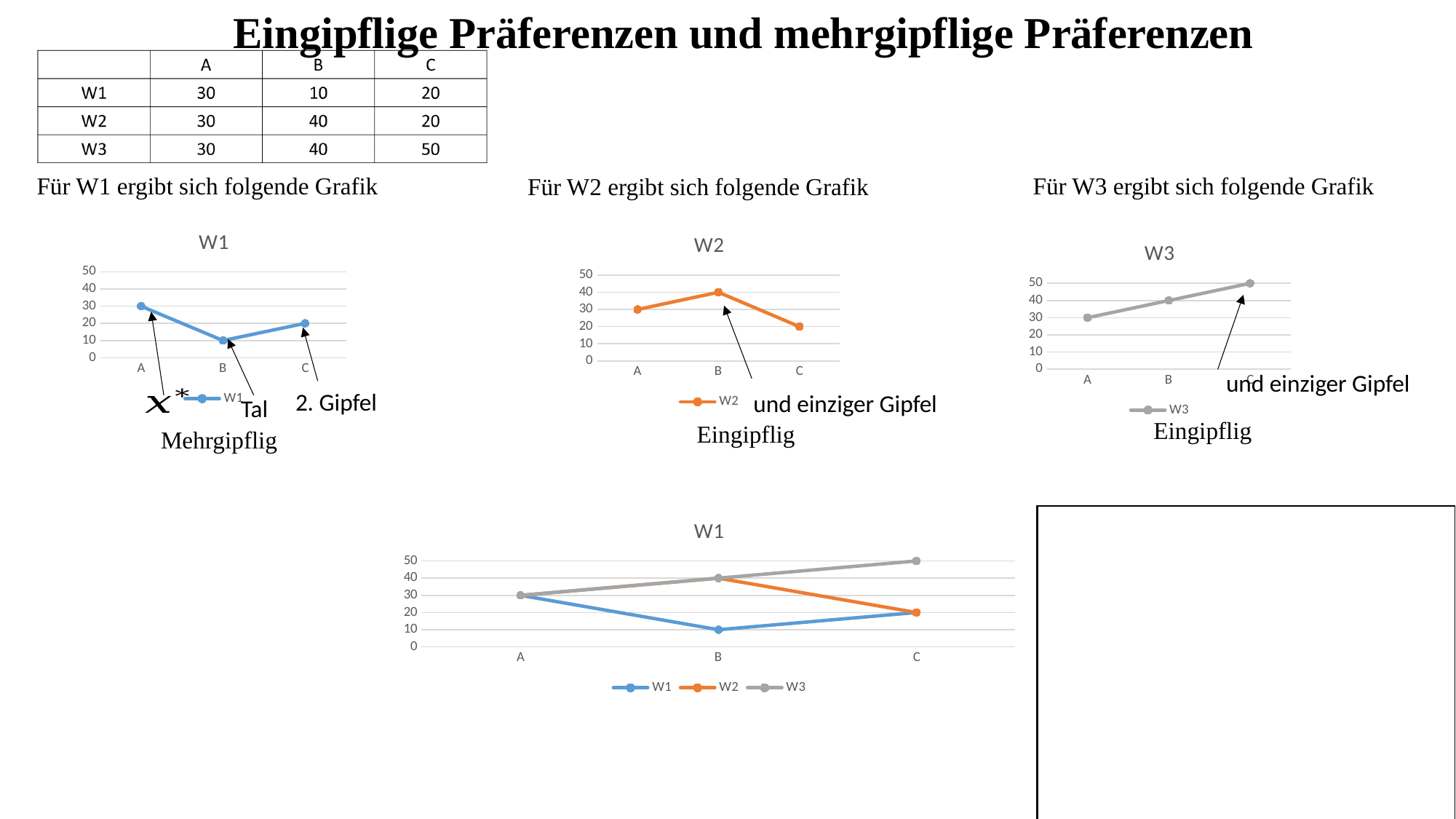
In the top-right chart titled W3, what is the value for C? 50 In the top-left chart titled W1, which category has the highest value? A In the top-right chart titled W3, do the values rise or fall from A to C? rise In the top-middle chart titled W2, what is the value for B? 40 In the top-left chart titled W1, what is the value for B? 10 What kind of chart is the top-middle chart titled W2? line chart In the bottom chart, how many categories are shown on the x axis? 3 In the top-middle chart titled W2, which category has the lowest value? C In the top-right chart titled W3, what is the difference between the values for C and A? 20 In the bottom chart, what is the value of W1 at C? 20 In the bottom chart, how many series does the legend list? 3 In the bottom chart, which series has the higher value at C, W2 or W3? W3